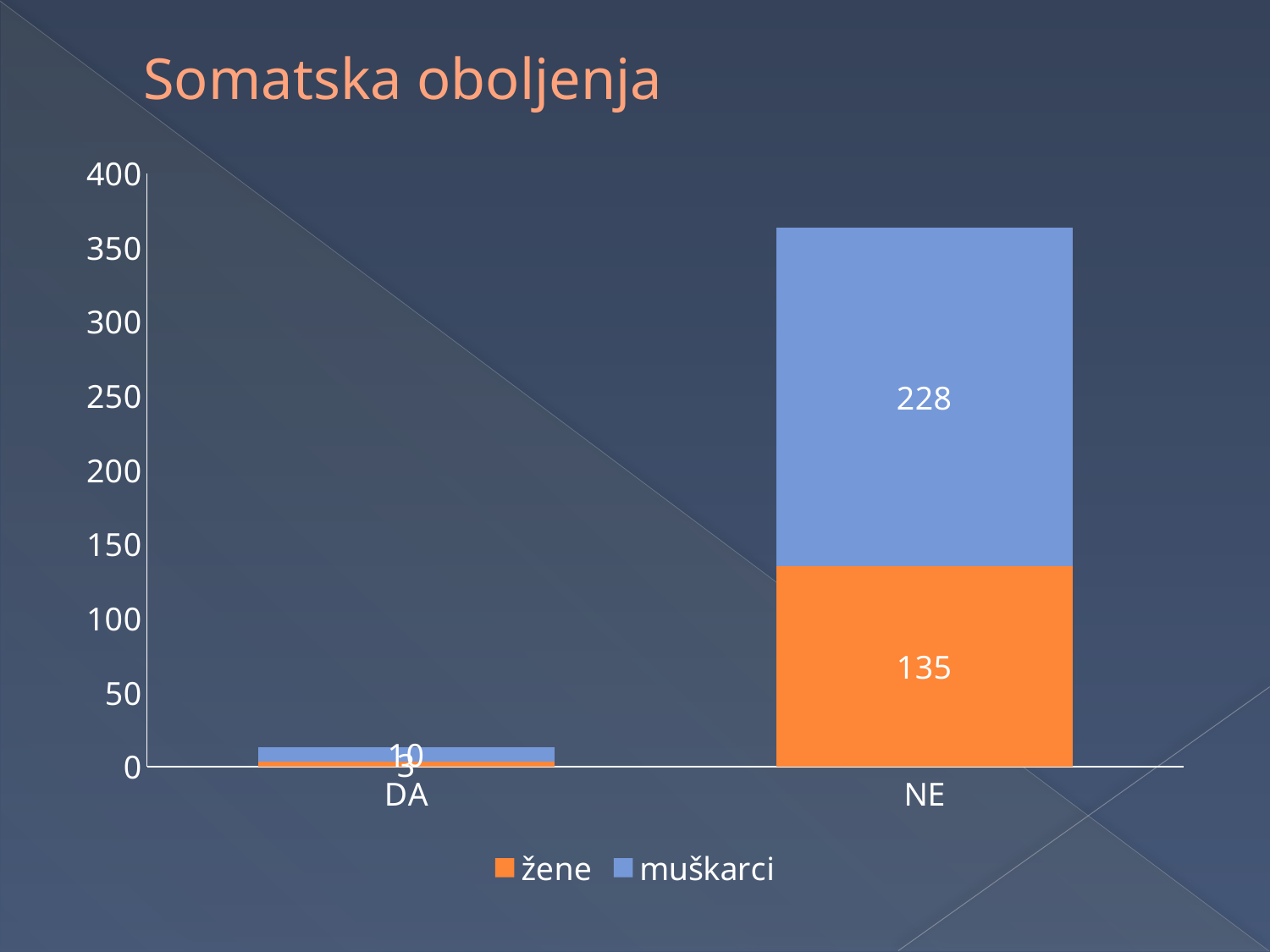
What is the difference between muškarci and žene in the NE category? 93 Is the total value for DA greater or less than 50? less What kind of chart is shown on the slide? stacked bar chart What is the title of the chart? Somatska oboljenja What is the value for muškarci in the NE category? 228 What is the total of the stacked bar for NE? 363 Which series is shown in orange? žene How many categories are shown on the x axis? 2 How many series does the legend list? 2 In the NE category, which is larger, žene or muškarci? muškarci Which category has the highest total bar? NE What is the value for žene in the NE category? 135